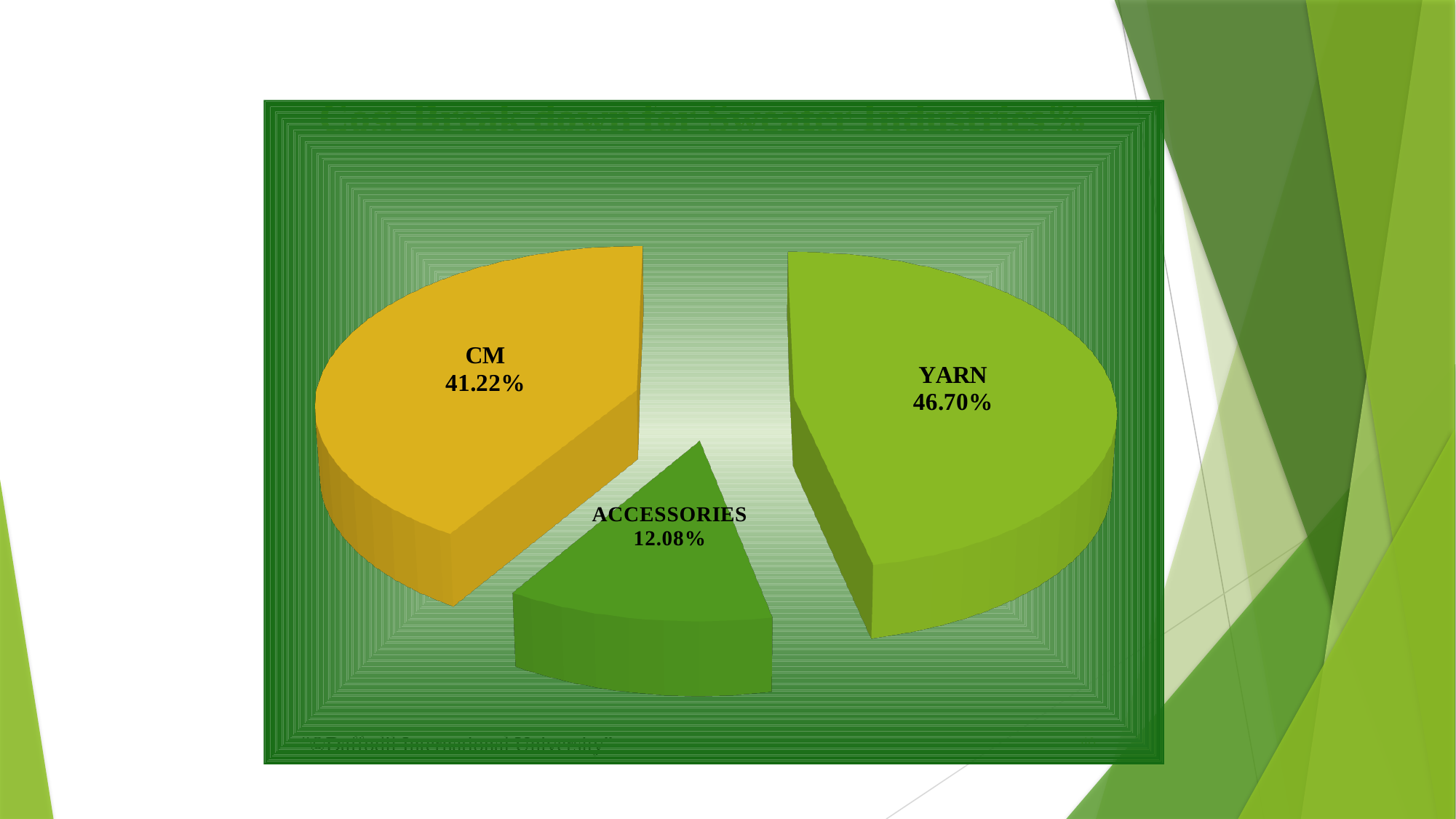
Which slice of the pie is the smallest? ACCESSORIES What share of the pie does YARN represent? 46.70% What colour is the CM slice? yellow Which slice of the pie is the largest? YARN What is the difference between the YARN and CM values? 5.48% What is the value shown for CM? 41.22% What kind of chart is shown on the slide? pie chart What is the value shown for YARN? 46.70% Which is larger, the value for CM or the value for ACCESSORIES? CM What is the value shown for ACCESSORIES? 12.08% How many slices does the pie chart have? 3 What is the difference between the CM and ACCESSORIES values? 29.14%